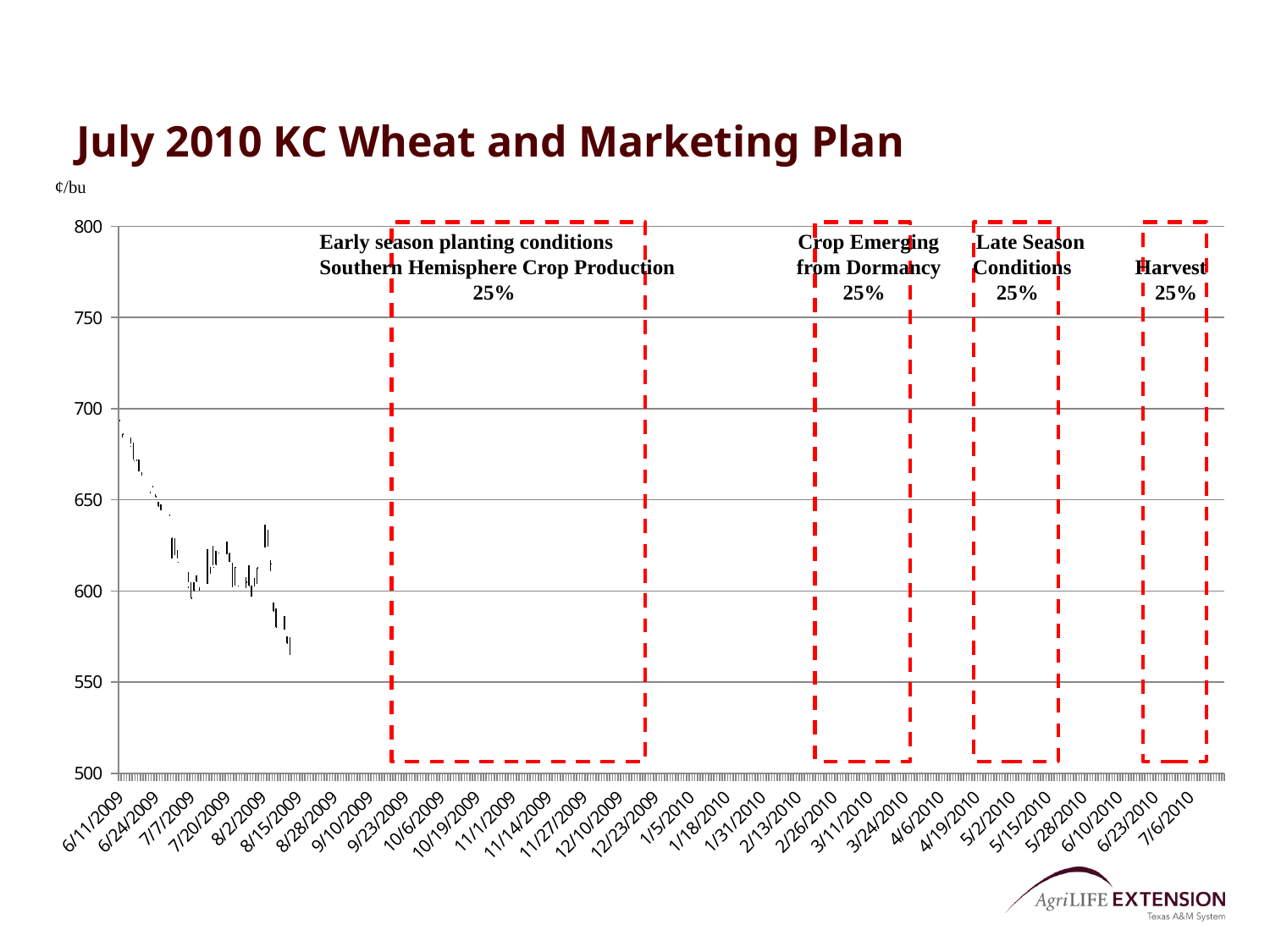
What kind of chart is used to plot the wheat prices? stock (high-low) chart What percentage is assigned to the 'Early season planting conditions / Southern Hemisphere Crop Production' window? 25% What is the highest value shown on the vertical axis of the chart? 800 What percentage is assigned to the 'Harvest' window? 25% Do the plotted prices generally rise or fall from 6/11/2009 to 8/15/2009? fall What is the combined percentage of the four marketing-plan windows shown on the chart? 100% What unit is shown on the vertical axis of the chart? ¢/bu Is the price plotted at the end of the series (around 8/15/2009) greater or less than 600? less How many dashed marketing-plan windows are drawn on the chart? 4 Is the price plotted at the start of the series (around 6/11/2009) greater or less than 650? greater What is the title of the chart on the slide? July 2010 KC Wheat and Marketing Plan Is the price plotted around 7/20/2009 greater or less than 650? less